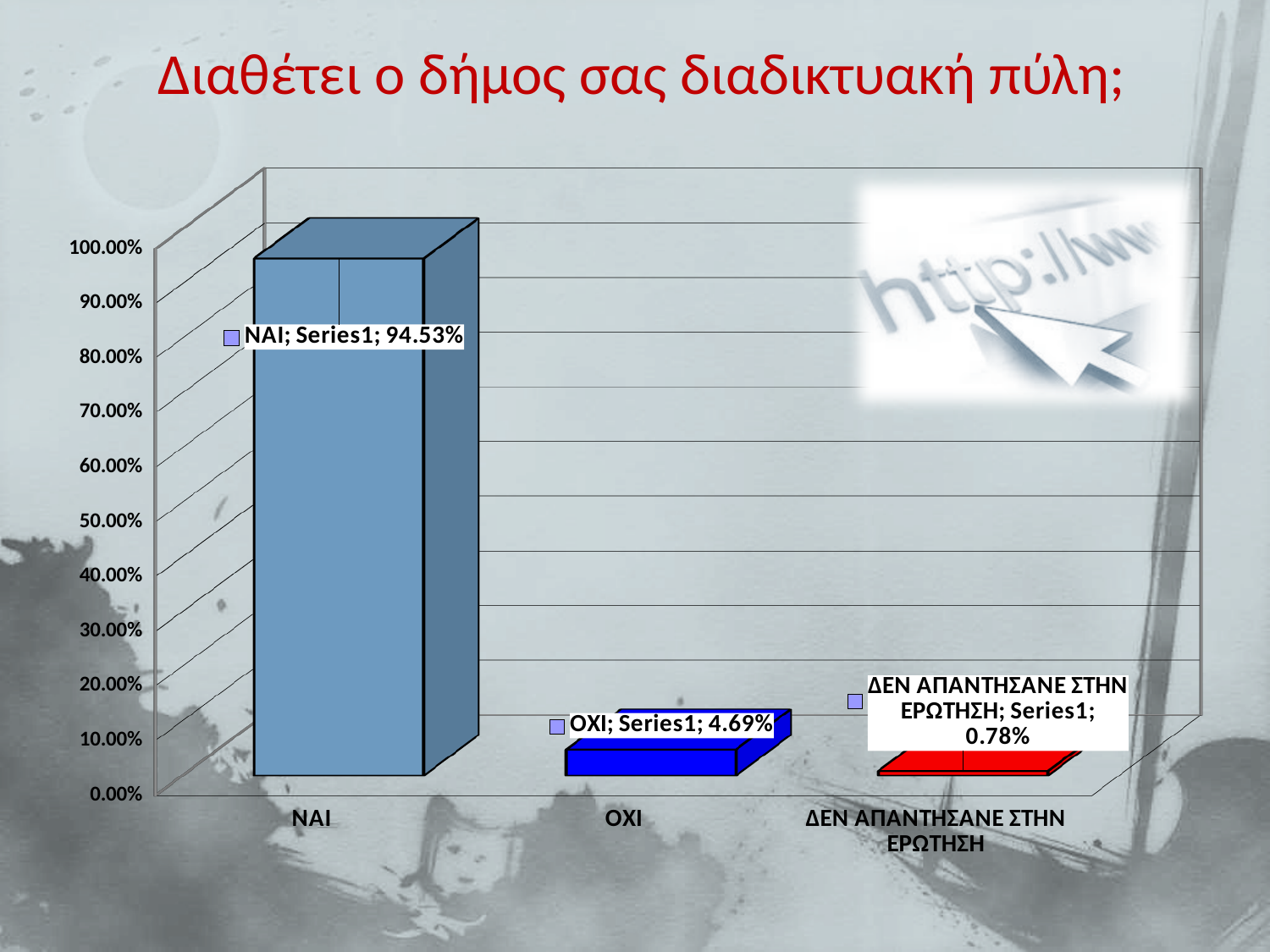
Which category has the lowest value? ΔΕΝ ΑΠΑΝΤΗΣΑΝΕ ΣΤΗΝ ΕΡΩΤΗΣΗ What is the value for ΔΕΝ ΑΠΑΝΤΗΣΑΝΕ ΣΤΗΝ ΕΡΩΤΗΣΗ? 0.78% What is the difference between the values for ΝΑΙ and ΟΧΙ? 89.84% What is the difference between the values for ΟΧΙ and ΔΕΝ ΑΠΑΝΤΗΣΑΝΕ ΣΤΗΝ ΕΡΩΤΗΣΗ? 3.91% What is the value for ΟΧΙ? 4.69% What is the title of the slide? Διαθέτει ο δήμος σας διαδικτυακή πύλη; How many categories are shown on the x axis? 3 Is the value for ΝΑΙ greater or less than 90.00%? greater Which is larger, the value for ΟΧΙ or the value for ΔΕΝ ΑΠΑΝΤΗΣΑΝΕ ΣΤΗΝ ΕΡΩΤΗΣΗ? ΟΧΙ Which category has the highest value? ΝΑΙ What kind of chart is shown on the slide? bar chart What is the value for ΝΑΙ? 94.53%